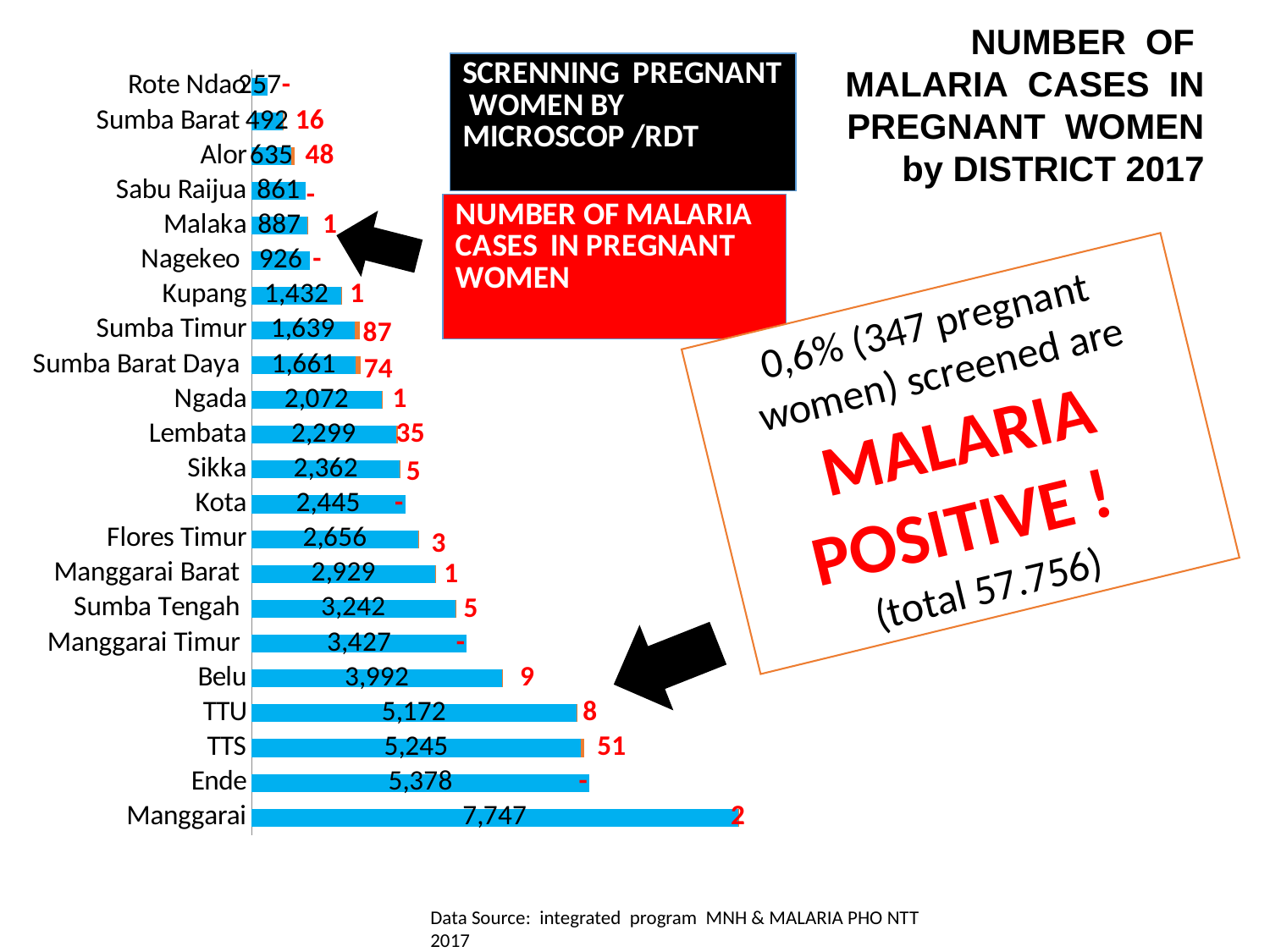
How many districts are shown in the chart? 22 Which district has the lowest number of pregnant women screened? Rote Ndao Which district has the highest number of malaria cases in pregnant women? Sumba Timur What is the difference between the malaria cases in Sumba Timur and in Sumba Barat Daya? 13 How many malaria cases in pregnant women are shown for Alor? 48 Which district screened more pregnant women, Ende or TTS? Ende What type of chart is shown on the slide? Bar chart How many malaria cases in pregnant women are shown for Sumba Timur? 87 Which district has the highest number of pregnant women screened? Manggarai What is the difference between the number of pregnant women screened in TTS and in TTU? 73 How many pregnant women were screened by microscope/RDT in Manggarai? 7,747 How many data series does the chart show? 2